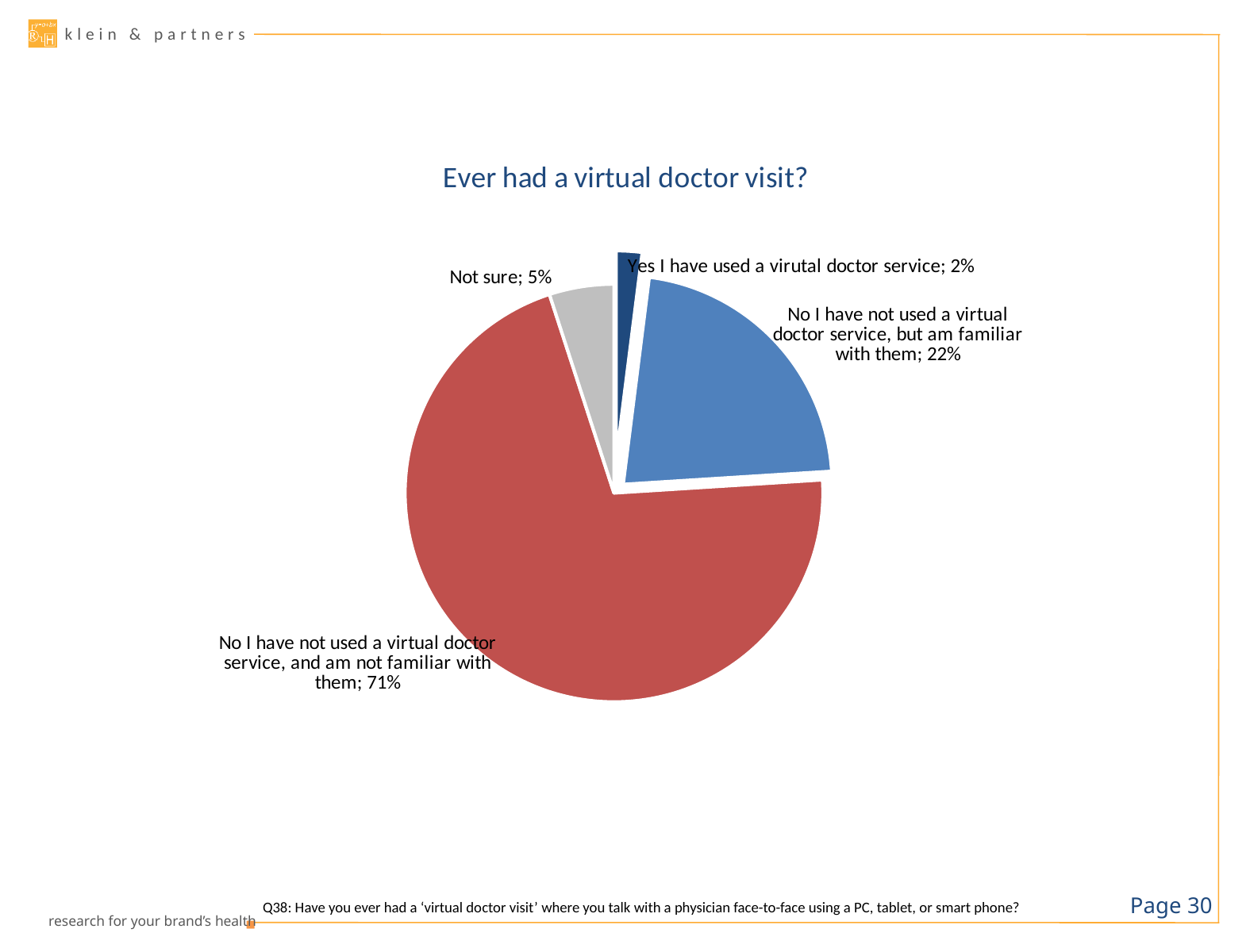
What percentage of respondents answered 'Not sure'? 5% What percentage of respondents said they have used a virtual doctor service? 2% What colour is the slice for 'No I have not used a virtual doctor service, but am familiar with them'? Blue Which is larger: the 'Not sure' share or the 'Yes I have used a virutal doctor service' share? Not sure What percentage of respondents have not used a virtual doctor service and are not familiar with them? 71% What is the difference in percentage points between those not familiar with virtual doctor services (71%) and those familiar but who have not used them (22%)? 49 How many slices does the pie chart have? 4 What is the title of the chart? Ever had a virtual doctor visit? What kind of chart is shown on the slide? Pie chart Which response has the smallest share of the pie? Yes I have used a virutal doctor service Which response has the largest share of the pie? No I have not used a virtual doctor service, and am not familiar with them What percentage of respondents have not used a virtual doctor service but are familiar with them? 22%